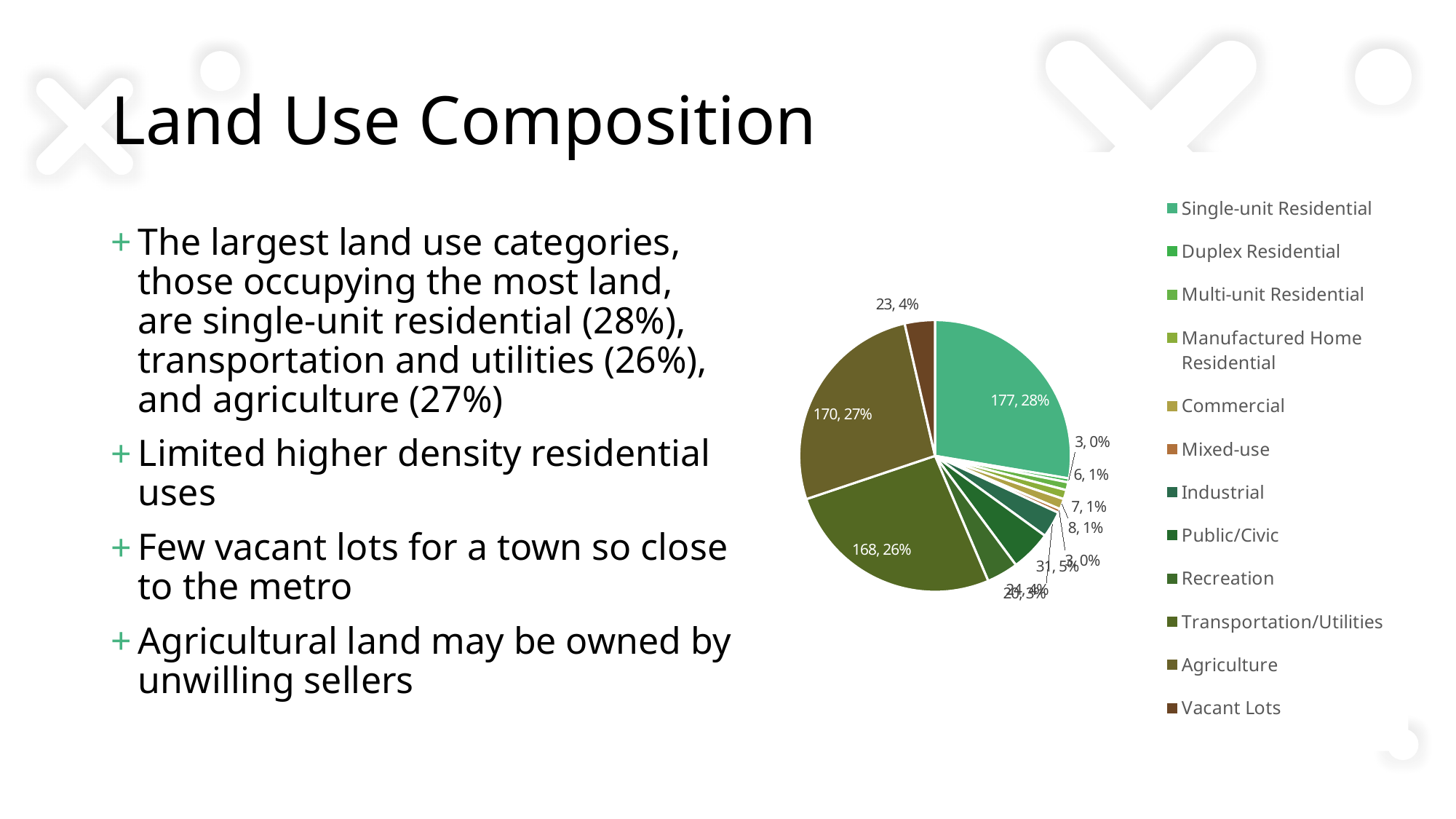
What share of the pie does Agriculture represent? 27% What is the difference between the Agriculture value and the Transportation/Utilities value? 2 What value is labelled on the Agriculture slice? 170 What kind of chart is shown on the slide? Pie chart Which is larger, the Single-unit Residential slice or the Vacant Lots slice? Single-unit Residential What value is labelled on the Vacant Lots slice? 23 Which category has the largest slice of the pie chart? Single-unit Residential What value is labelled on the Single-unit Residential slice? 177 What value is labelled on the Transportation/Utilities slice? 168 How many categories does the legend of the pie chart list? 12 What share of the pie does Single-unit Residential represent? 28% What share of the pie does Transportation/Utilities represent? 26%